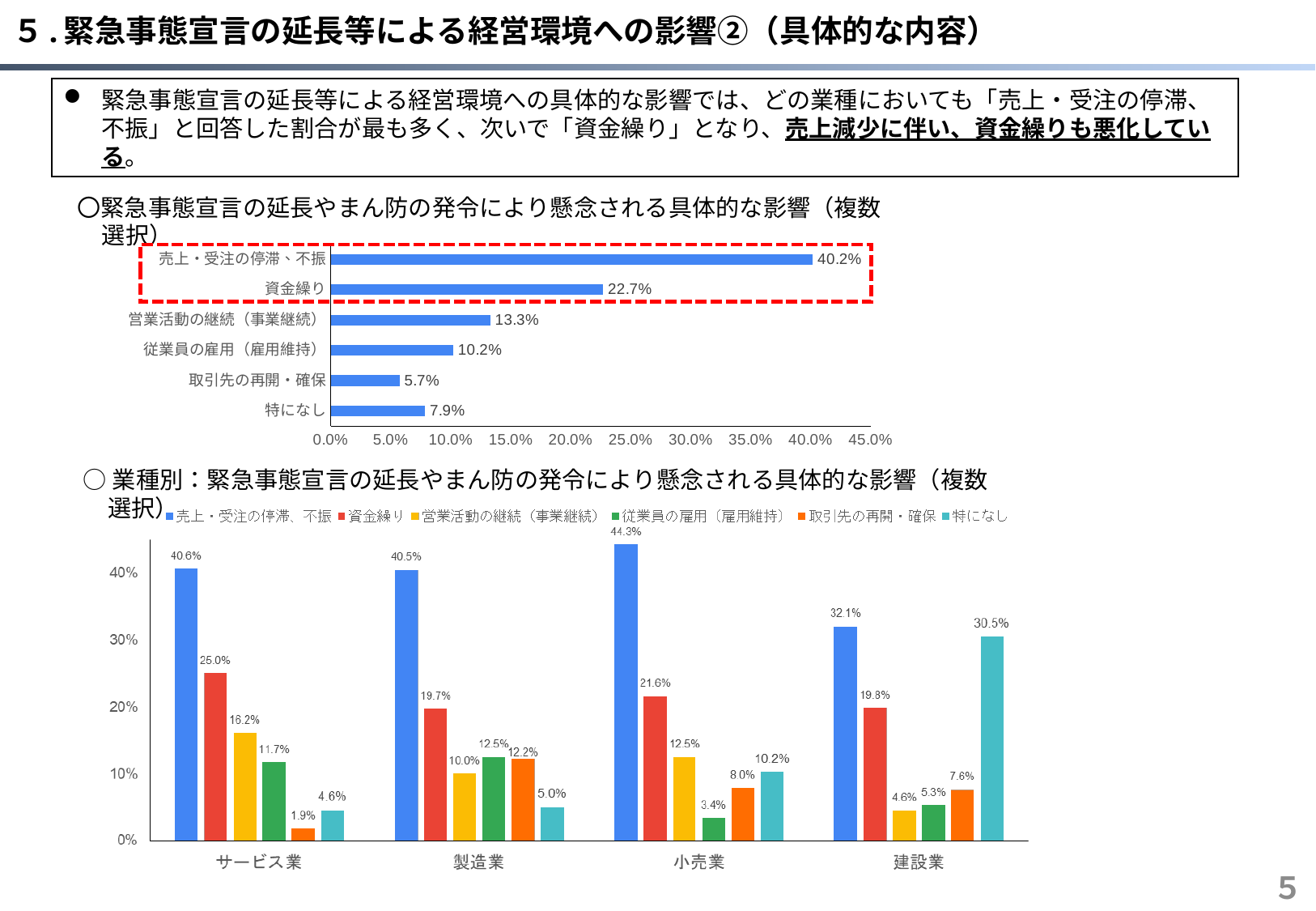
In the bottom chart (業種別), what is the difference between 売上・受注の停滞、不振 and 資金繰り in 建設業? 12.3% In the top chart, which category has the highest value? 売上・受注の停滞、不振 In the top chart, which category has the lowest value? 取引先の再開・確保 In the top chart, what is the difference between 売上・受注の停滞、不振 and 資金繰り? 17.5% In the bottom chart (業種別), which industry has the highest value for 売上・受注の停滞、不振? 小売業 In the bottom chart (業種別), what is the value for 特になし in 建設業? 30.5% In the bottom chart (業種別), what is the value for 資金繰り in 小売業? 21.6% What kind of chart is the top chart? Bar chart In the top chart, how many categories are shown? 6 In the bottom chart (業種別), how many series does the legend list? 6 In the bottom chart (業種別), which is larger: 営業活動の継続（事業継続） in サービス業 or in 製造業? サービス業 In the top chart (緊急事態宣言の延長やまん防の発令により懸念される具体的な影響), what is the value for 資金繰り? 22.7%